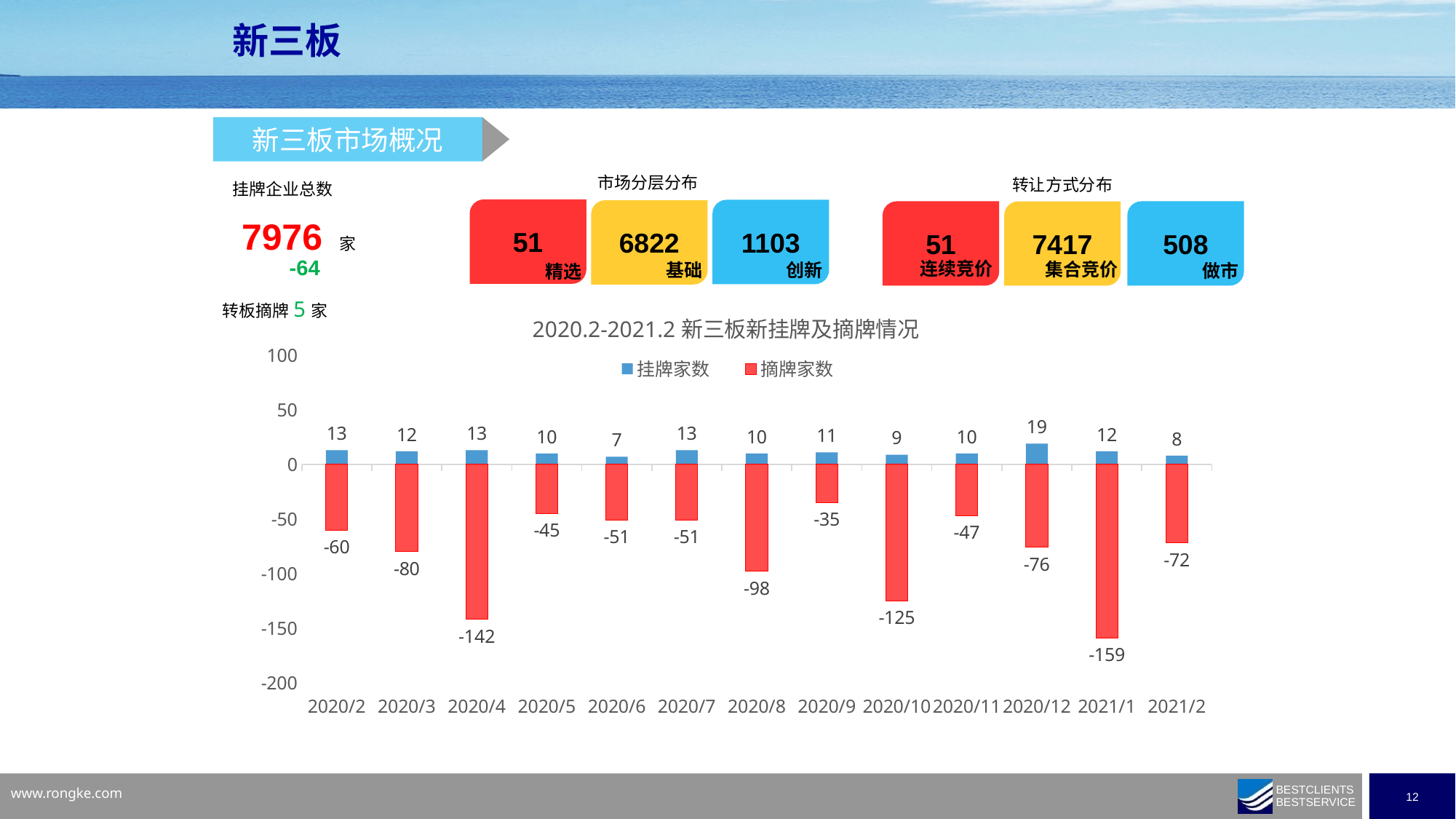
Which is larger in absolute value, the 摘牌家数 for 2020/8 or for 2020/10? 2020/10 Which month has the smallest 摘牌家数 in absolute terms (the shortest red bar)? 2020/9 Which month has the highest 挂牌家数? 2020/12 What is the value of 摘牌家数 for 2021/1? -159 What is the difference between the 挂牌家数 for 2020/12 and 2021/2? 11 What is the title of the chart? 2020.2-2021.2 新三板新挂牌及摘牌情况 What is the value of 挂牌家数 for 2020/12? 19 What kind of chart is shown on the slide? Bar chart How many series does the chart legend list? 2 How many months are shown on the x axis of the chart? 13 What is the value of 摘牌家数 for 2020/4? -142 Which month has the lowest 挂牌家数? 2020/6